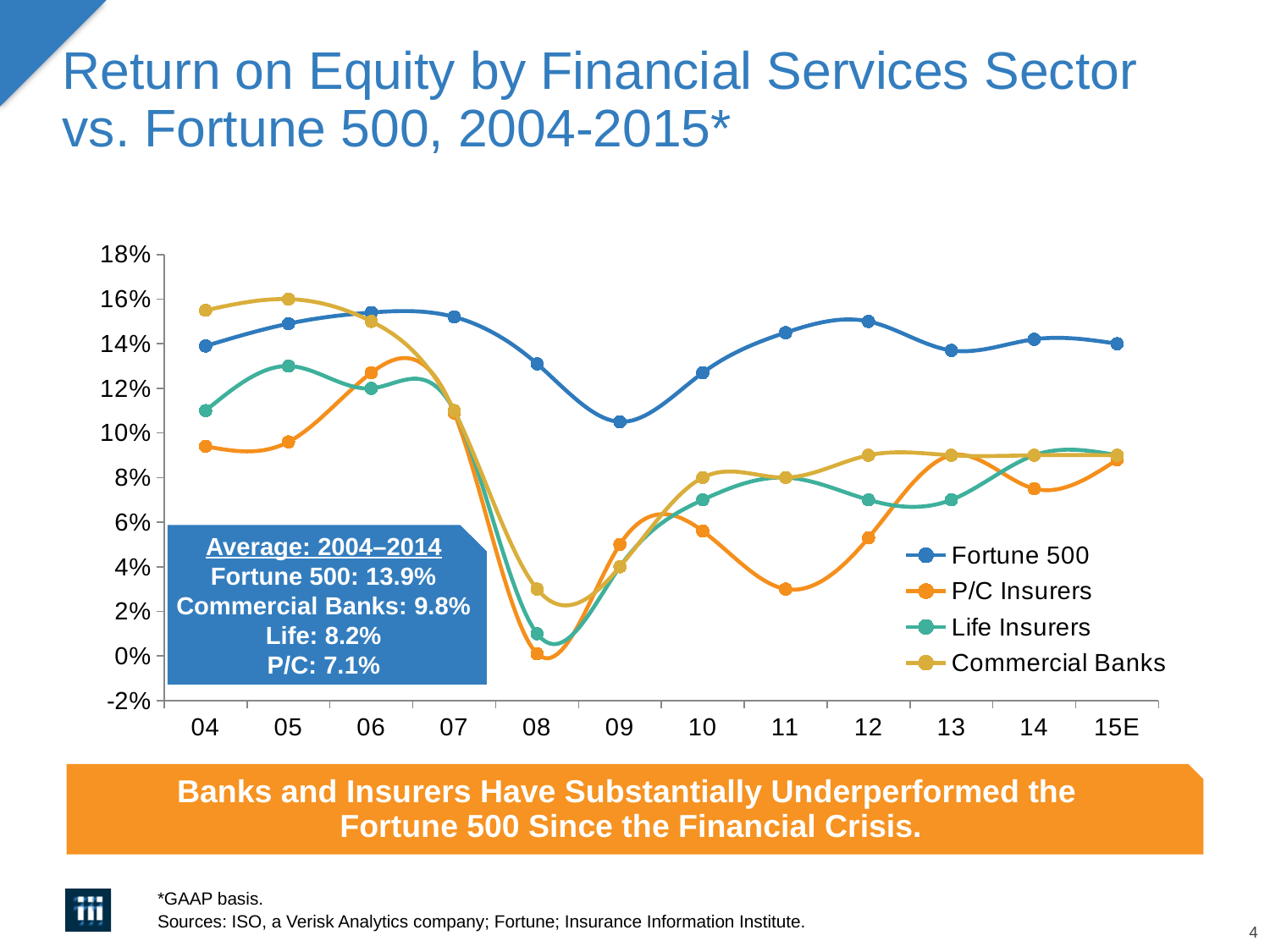
What kind of chart is shown on the slide? line chart What is the return on equity for Commercial Banks in 2009? 4% How many series does the legend list? 4 Which series has the highest return on equity in 2009? Fortune 500 Is the value for P/C Insurers in 2011 greater or less than 4%? less What is the return on equity for the Fortune 500 in 15E? 14% How many years are plotted along the x axis? 12 Which series has the lowest return on equity in 2011? P/C Insurers According to the text box, what was the average return on equity for the Fortune 500 over 2004–2014? 13.9% Is the value for the Fortune 500 in 2009 greater or less than 12%? less What is the return on equity for Commercial Banks in 2005? 16%